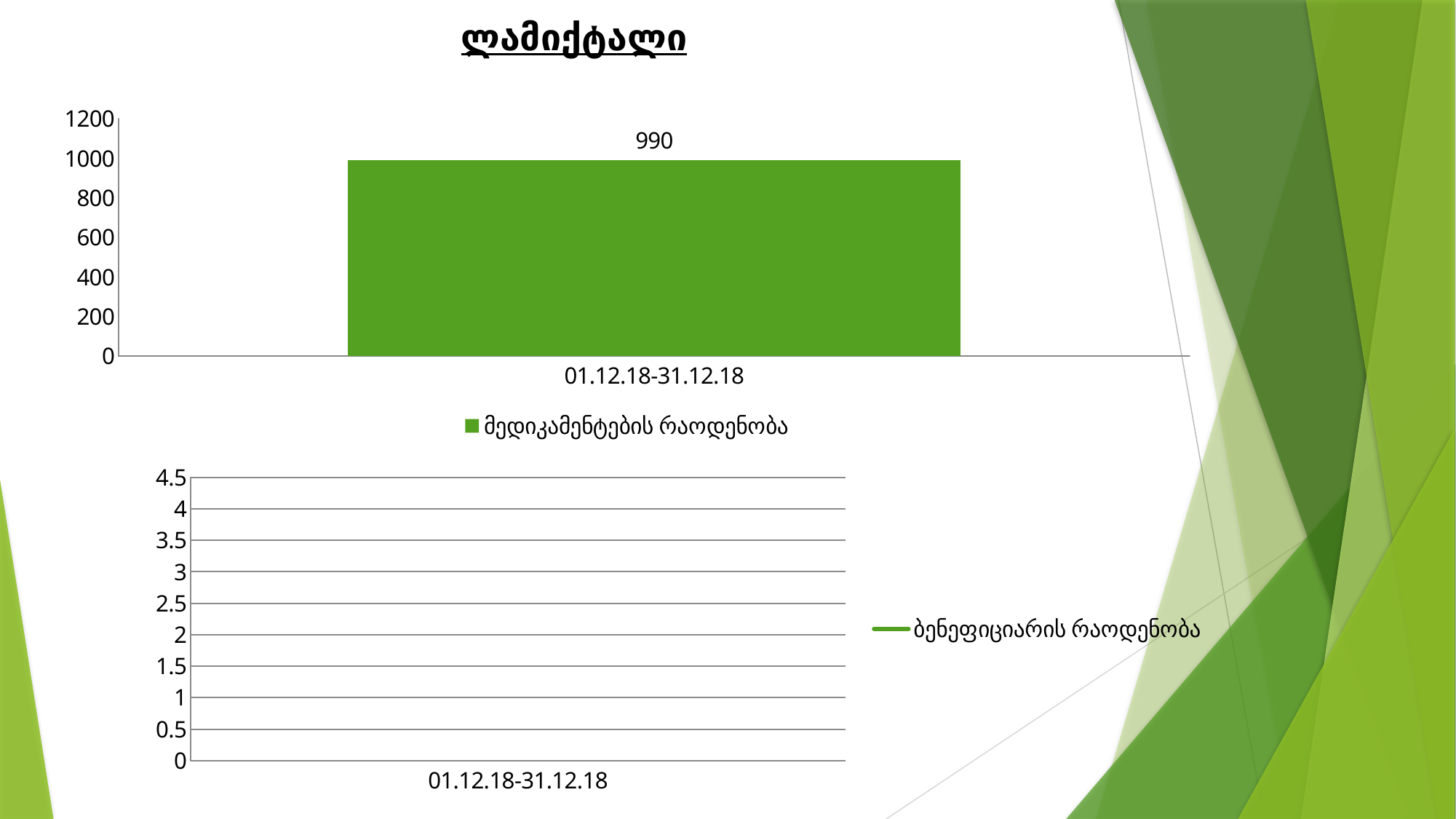
How many series does the legend of the bottom chart list? 1 In the top chart, is the value for 01.12.18-31.12.18 greater or less than 800? greater What kind of chart is the top chart on the slide? bar chart What is the series name shown in the legend of the top chart? მედიკამენტების რაოდენობა In the top chart, what is the value for 01.12.18-31.12.18? 990 In the top chart, is the value for 01.12.18-31.12.18 greater or less than 1000? less How many categories are shown on the x axis of the bottom chart? 1 How many categories are shown on the x axis of the top chart? 1 How many series does the legend of the top chart list? 1 What is the series name shown in the legend of the bottom chart? ბენეფიციარის რაოდენობა What kind of chart is the bottom chart on the slide? line chart